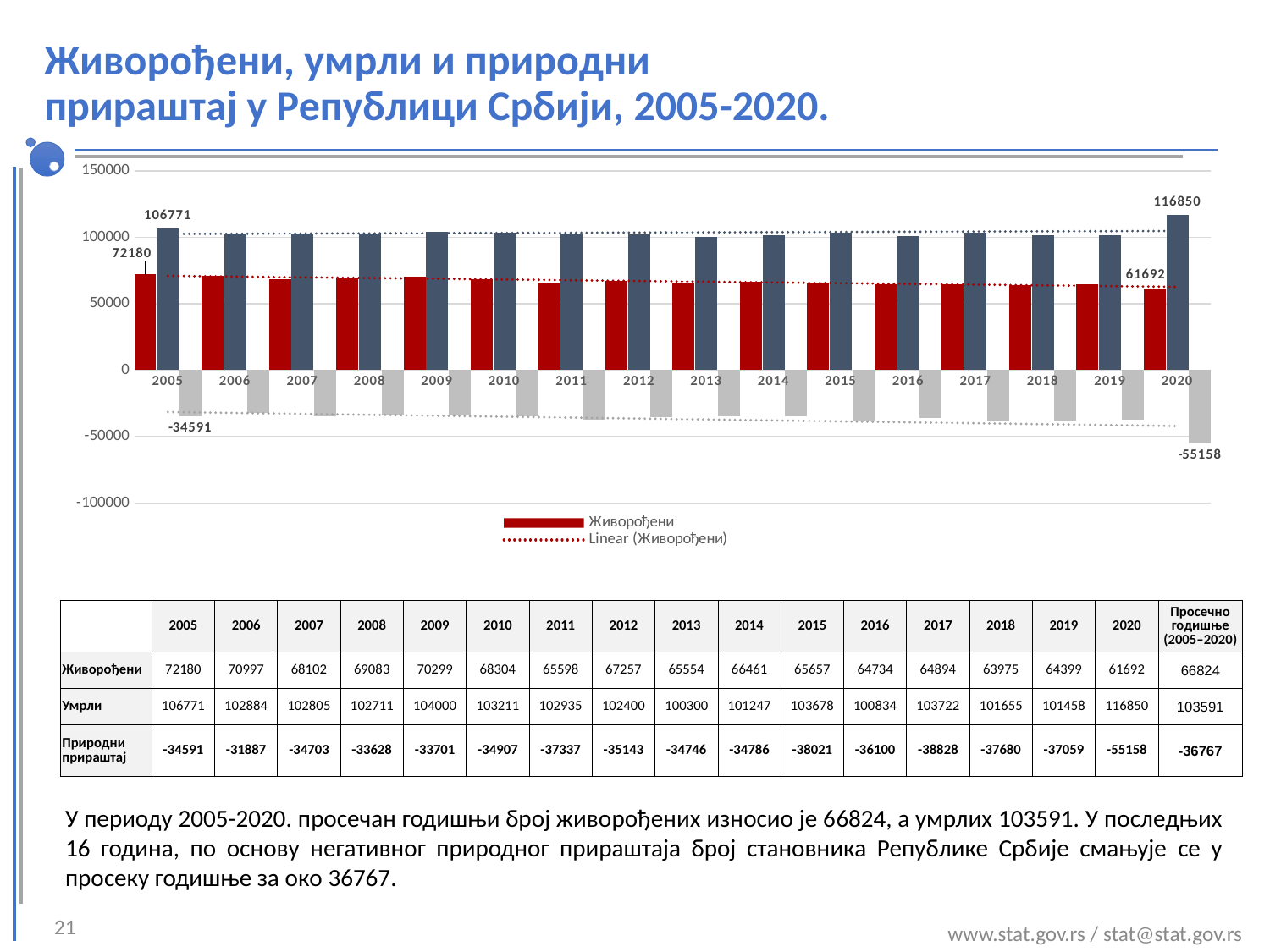
What kind of chart is shown on the slide? bar chart What is the value for Живорођени in 2005? 72180 Do the Живорођени values generally rise or fall from 2005 to 2020? fall What is the value for Умрли in 2020? 116850 What is the difference between the Умрли values for 2020 and 2005? 10079 Which year has the larger Живорођени value, 2005 or 2020? 2005 What is the value for Живорођени in 2020? 61692 What is the difference between the Живорођени values for 2005 and 2020? 10488 What is the value for Природни прираштај in 2005? -34591 Is the Умрли value for 2010 greater or less than 50000? greater How many years are shown on the x axis of the chart? 16 In which year is the Умрли value highest? 2020